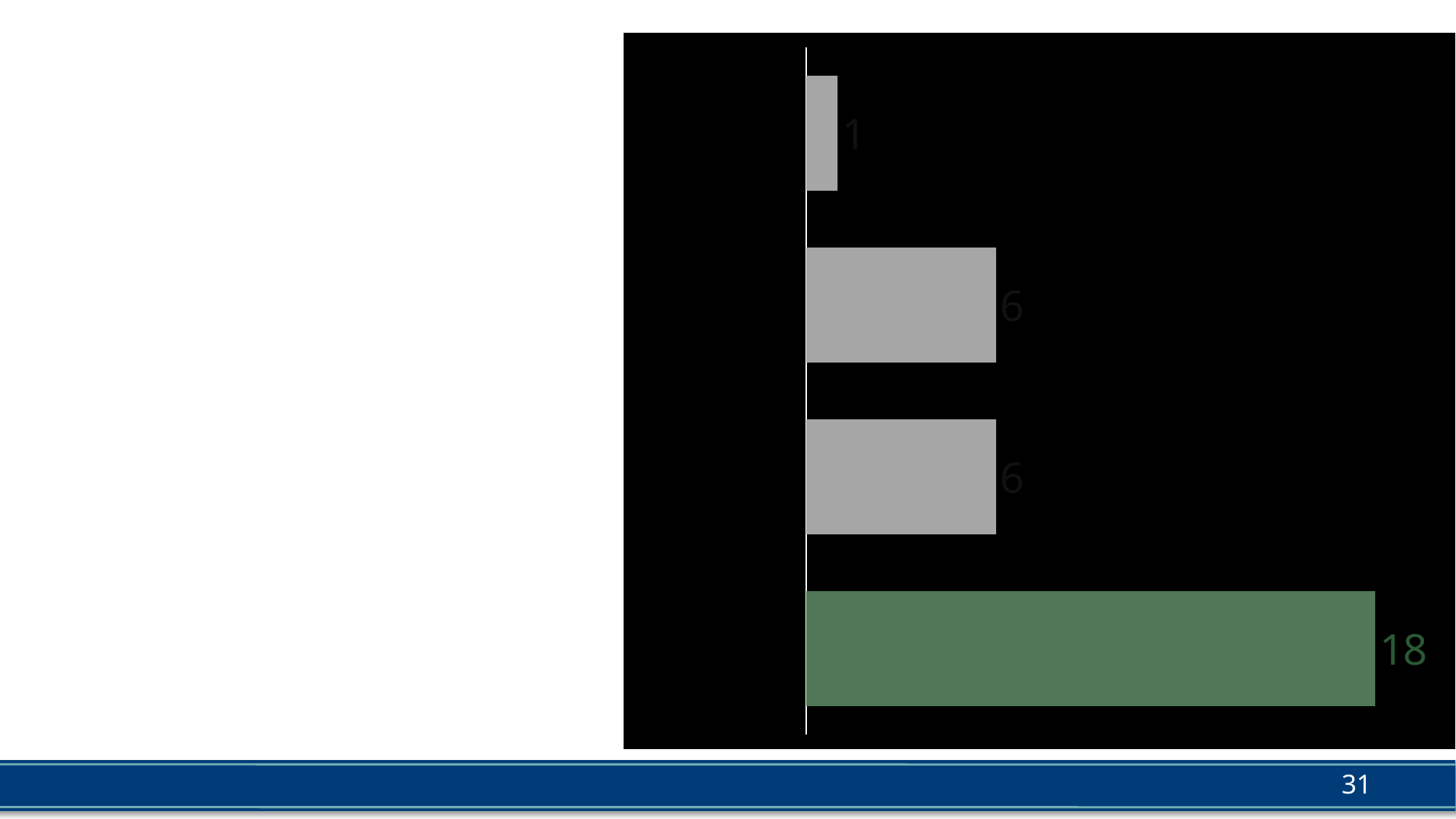
What is the value of the top bar in the chart? 1 How many of the bars are grey? 3 Which is larger, the value of the top bar or the value of the second bar? the second bar What kind of chart is shown on the slide? bar chart Which bar has the highest value? the bottom (green) bar What is the value of the second bar from the top? 6 What is the difference between the bottom bar's value and the third bar's value? 12 Which bar has the lowest value? the top bar What is the difference between the bottom bar's value and the top bar's value? 17 How many bars does the chart show? 4 What is the value of the bottom (green) bar in the chart? 18 What colour is the bar with the value 18? green